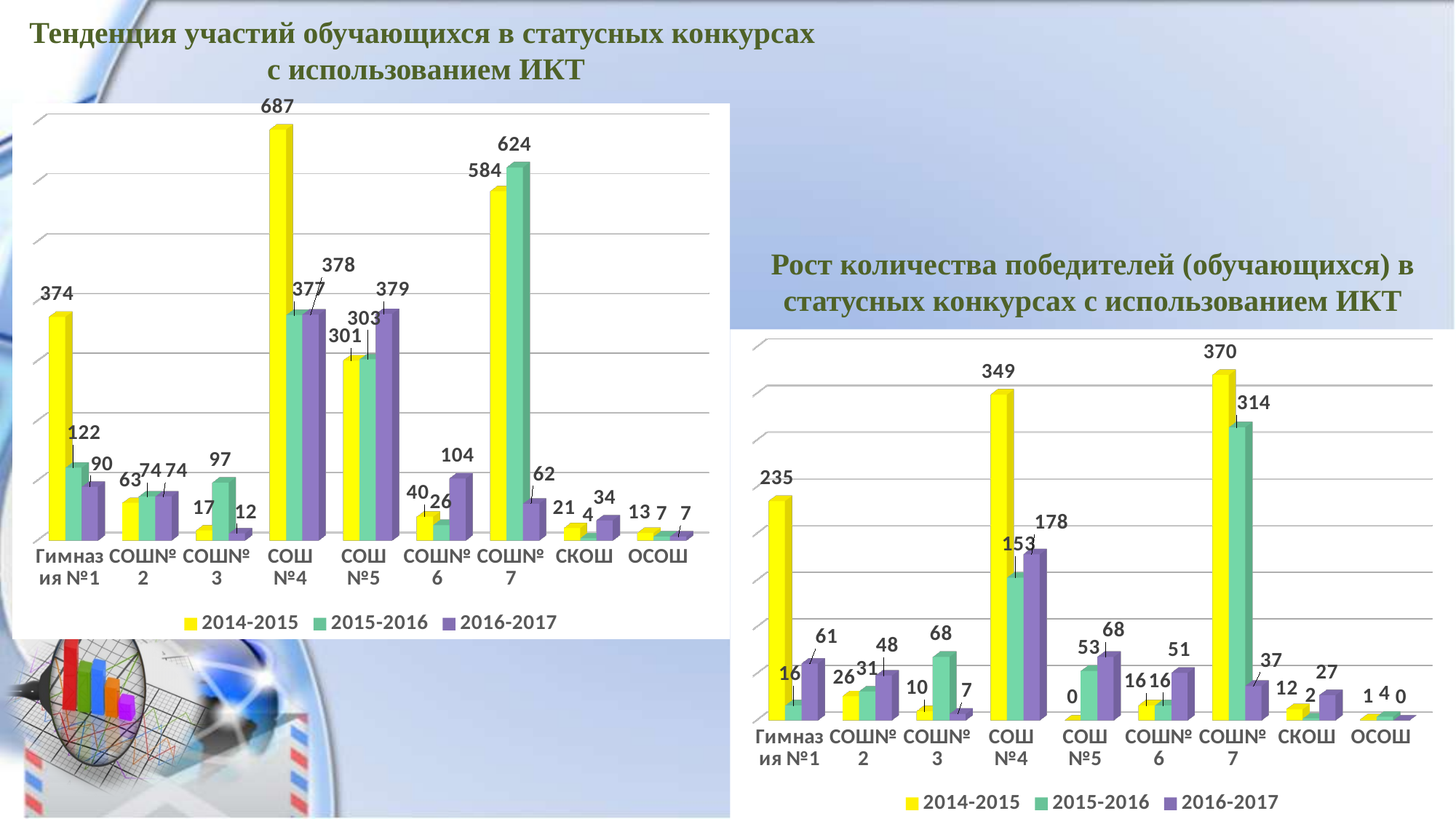
In the left chart (Тенденция участий обучающихся), which is larger for СОШ№6: the 2014-2015 value or the 2016-2017 value? 2016-2017 In the left chart (Тенденция участий обучающихся), how many schools are shown on the x axis? 9 In the right chart (Рост количества победителей), what is the value for СОШ №4 in 2014-2015? 349 In the left chart (Тенденция участий обучающихся), what is the value for СОШ №4 in 2014-2015? 687 How many series does the legend of the right chart (Рост количества победителей) list? 3 In the left chart (Тенденция участий обучающихся), what is the difference between the 2014-2015 and 2015-2016 values for Гимназия №1? 252 In the left chart (Тенденция участий обучающихся), which school has the highest value in 2016-2017? СОШ №5 In the left chart (Тенденция участий обучающихся), what is the value for СОШ№7 in 2015-2016? 624 What type of chart is the left chart (Тенденция участий обучающихся)? Bar chart In the right chart (Рост количества победителей), what is the value for СОШ №5 in 2014-2015? 0 In the right chart (Рост количества победителей), which school has the highest value in 2015-2016? СОШ№7 In the right chart (Рост количества победителей), what is the difference between the 2014-2015 and 2015-2016 values for СОШ№7? 56